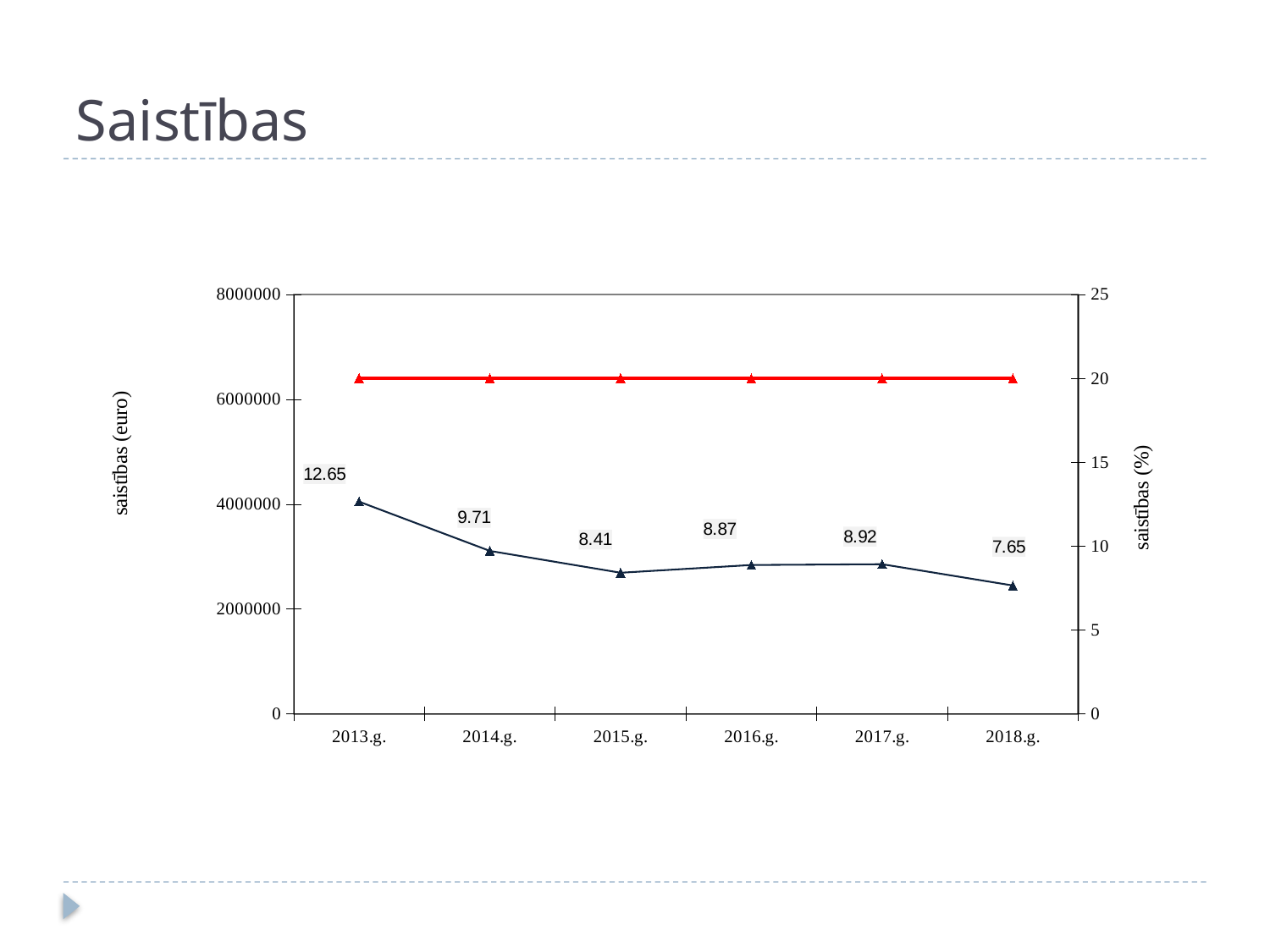
What is the difference between the labeled values for 2017.g. and 2018.g.? 1.27 Which year has the larger labeled value, 2016.g. or 2017.g.? 2017.g. Do the labeled values on the dark line rise or fall from 2013.g. to 2015.g.? fall Which year has the lowest labeled value on the dark line? 2018.g. What is the data label shown for 2015.g. on the dark line? 8.41 What is the difference between the labeled values for 2013.g. and 2014.g.? 2.94 What is the label of the right-hand vertical axis? saistības (%) How many years are shown on the x axis? 6 What is the data label shown for 2013.g. on the dark line? 12.65 What is the data label shown for 2018.g. on the dark line? 7.65 Which year has the highest labeled value on the dark line? 2013.g. What kind of chart is shown on the slide? line chart